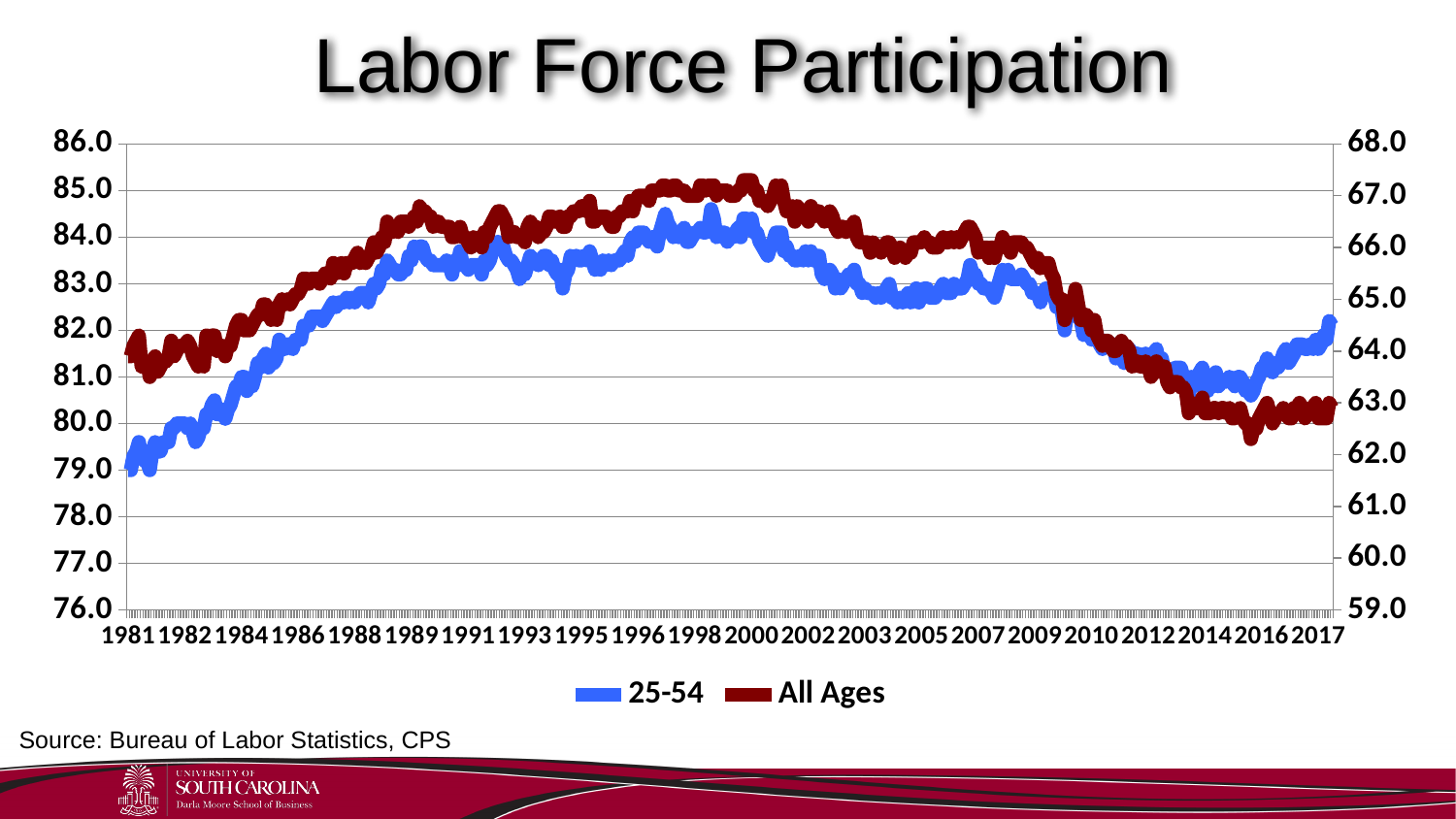
Reading the right axis, is the All Ages line at 2000 greater or less than 66.0? greater What is the title of the chart? Labor Force Participation Reading the left axis, is the 25-54 line at 1981 greater or less than 80.0? less Reading the left axis, is the 25-54 line at 2017 greater or less than 81.0? greater What kind of chart is shown on the slide? line chart What colour is the All Ages line? dark red Does the 25-54 line rise or fall between 2015 and 2017? rise How many series does the legend list? 2 How many year labels are shown along the x axis? 22 Does the All Ages line rise or fall between 2000 and 2015? fall Does the 25-54 line rise or fall between 1981 and 1999? rise